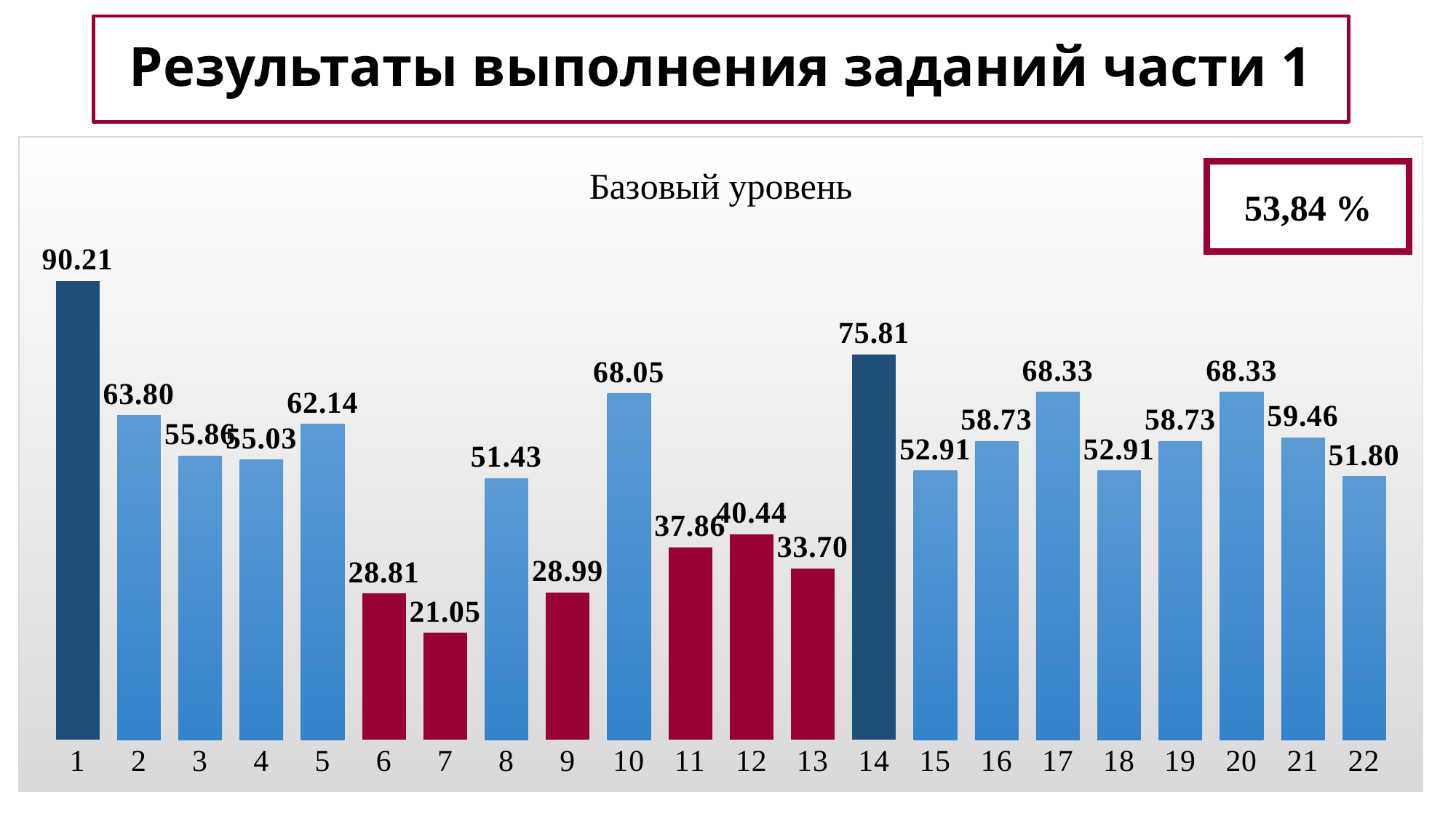
Which has the larger value, task 11 or task 12? task 12 What is the difference between the values for task 1 and task 14? 14.40 How many bars in the chart are coloured red? 6 Which task has the highest value? 1 What type of chart is shown on the slide? bar chart What is the value for task 1? 90.21 What is the value for task 14? 75.81 What is the value for task 7? 21.05 Which task has the lowest value? 7 How many categories (tasks) are shown on the x axis of the chart? 22 What is the title of the chart? Базовый уровень What is the value for task 10? 68.05